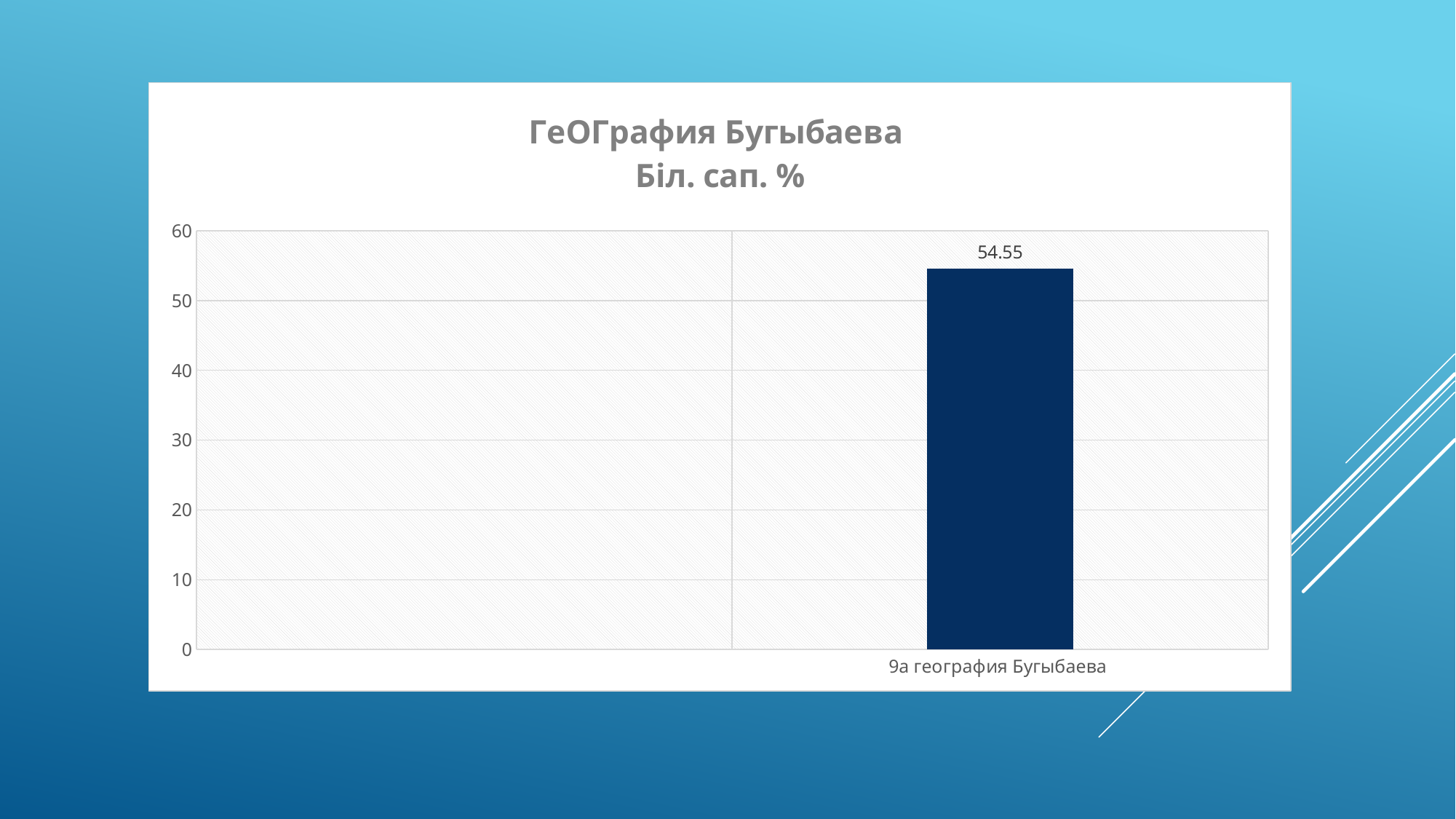
What is the highest value shown on the vertical axis? 60 What is the category label shown on the horizontal axis? 9а география Бугыбаева What is the title of the chart? ГеОГрафия Бугыбаева Біл. сап. % What is the value for 9а география Бугыбаева? 54.55 Is the value for 9а география Бугыбаева greater or less than 50? greater Is the value for 9а география Бугыбаева greater or less than 60? less How many bars are plotted in the chart? 1 What kind of chart is shown on the slide? bar chart